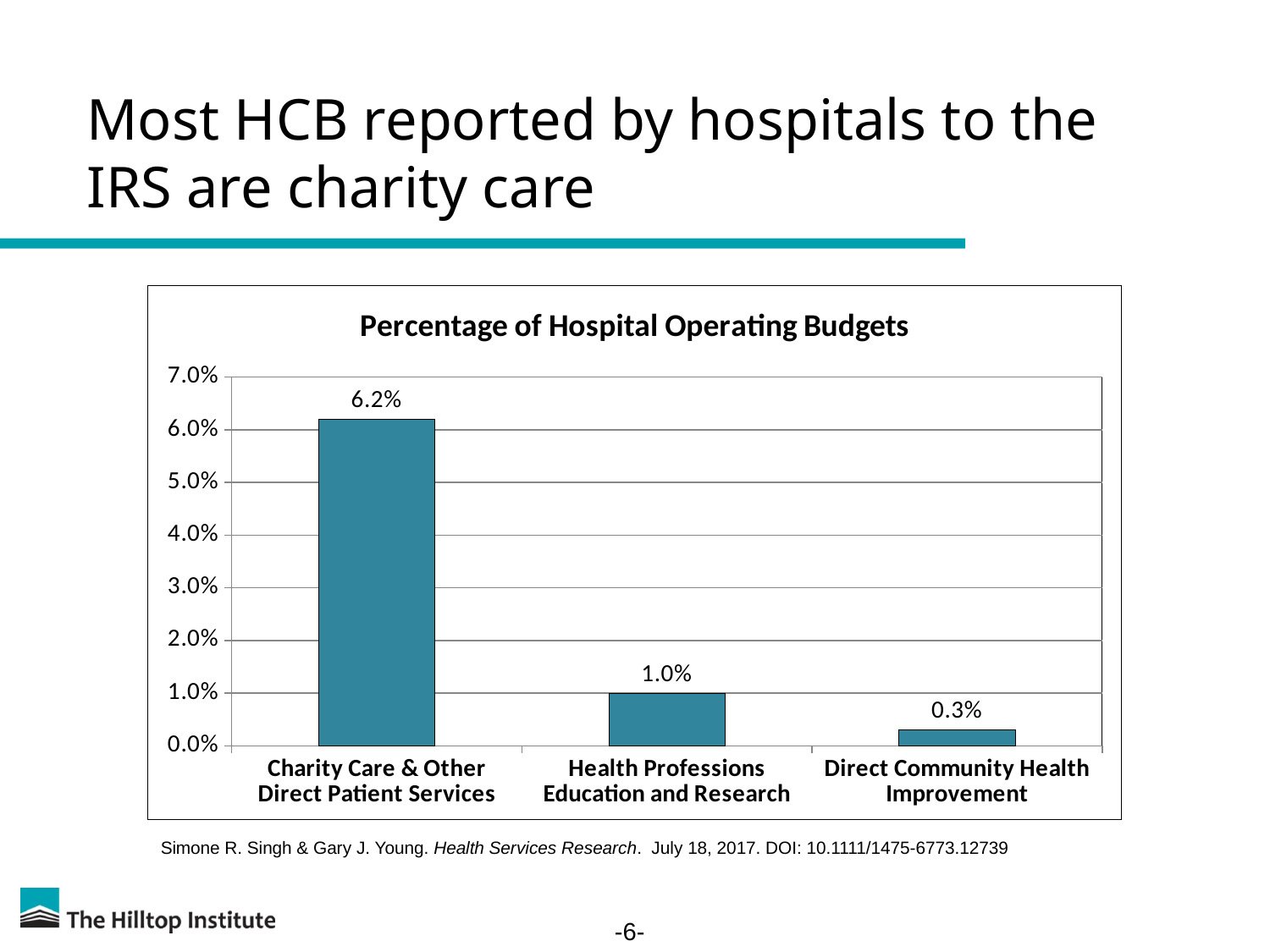
What is the value for Charity Care & Other Direct Patient Services? 6.2% Which category has the highest percentage of hospital operating budgets? Charity Care & Other Direct Patient Services What is the value for Health Professions Education and Research? 1.0% Is the value for Charity Care & Other Direct Patient Services greater or less than 5.0%? greater What is the difference between the values for Charity Care & Other Direct Patient Services and Health Professions Education and Research? 5.2% How many categories are shown in the chart? 3 What kind of chart is shown on the slide? Bar chart Which category has the lowest percentage of hospital operating budgets? Direct Community Health Improvement What is the title of the chart? Percentage of Hospital Operating Budgets What is the difference between the values for Health Professions Education and Research and Direct Community Health Improvement? 0.7% What is the value for Direct Community Health Improvement? 0.3% Which is larger: the value for Health Professions Education and Research or Direct Community Health Improvement? Health Professions Education and Research